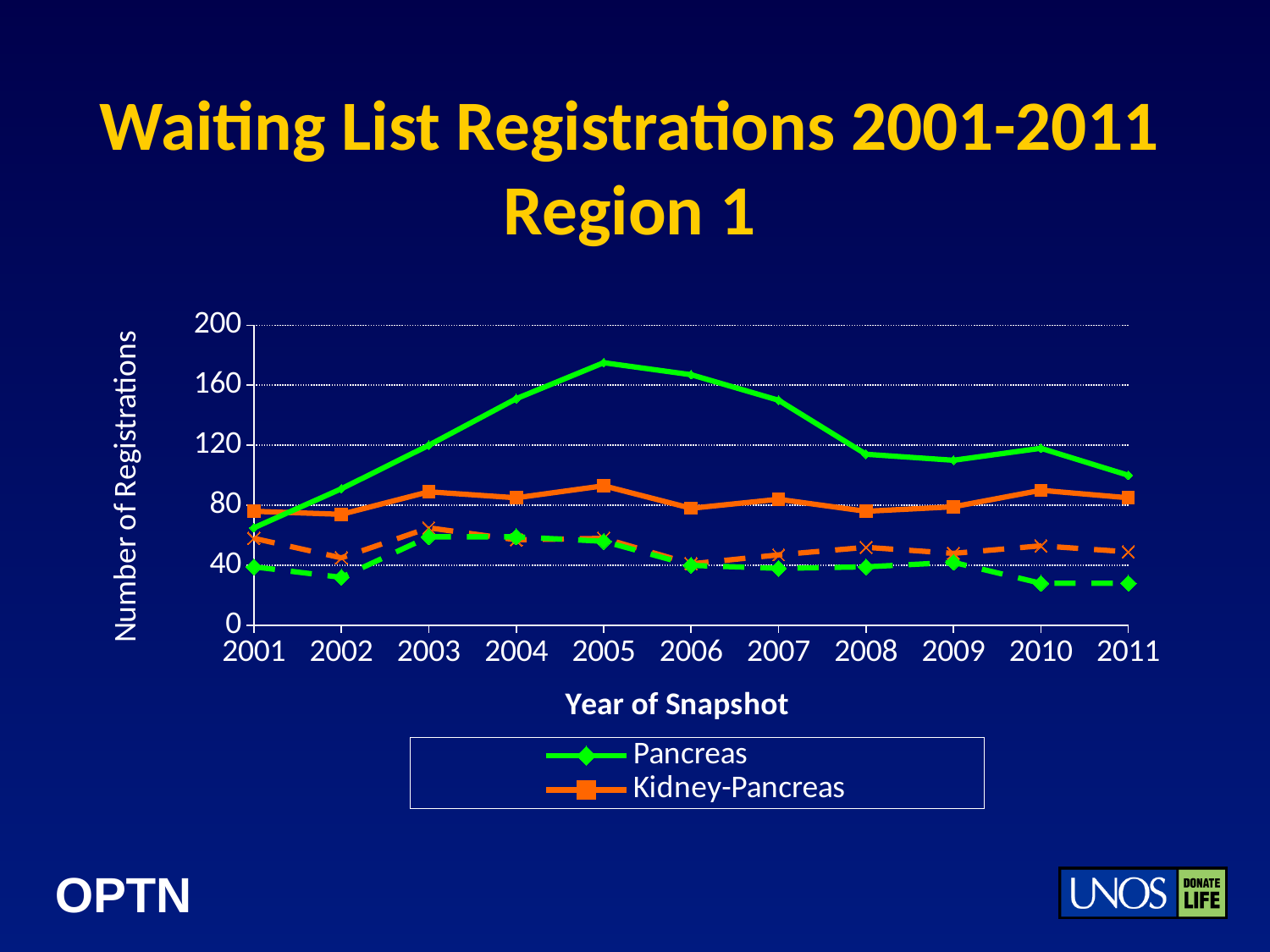
Is the value of the solid Kidney-Pancreas line in 2005 greater or less than 80? greater What kind of chart is shown on the slide? Line chart In which year does the solid Pancreas line reach its highest value? 2005 How many years are plotted along the x axis? 11 In 2005, which solid line is higher, Pancreas or Kidney-Pancreas? Pancreas Is the value of the solid Pancreas line in 2005 greater or less than 160? greater Is the value of the solid Pancreas line in 2001 greater or less than 80? less How many series does the legend list? 2 In which year is the solid Pancreas line at its lowest value? 2001 What is the title of the x axis? Year of Snapshot Does the solid Pancreas line rise or fall from 2005 to 2008? Fall